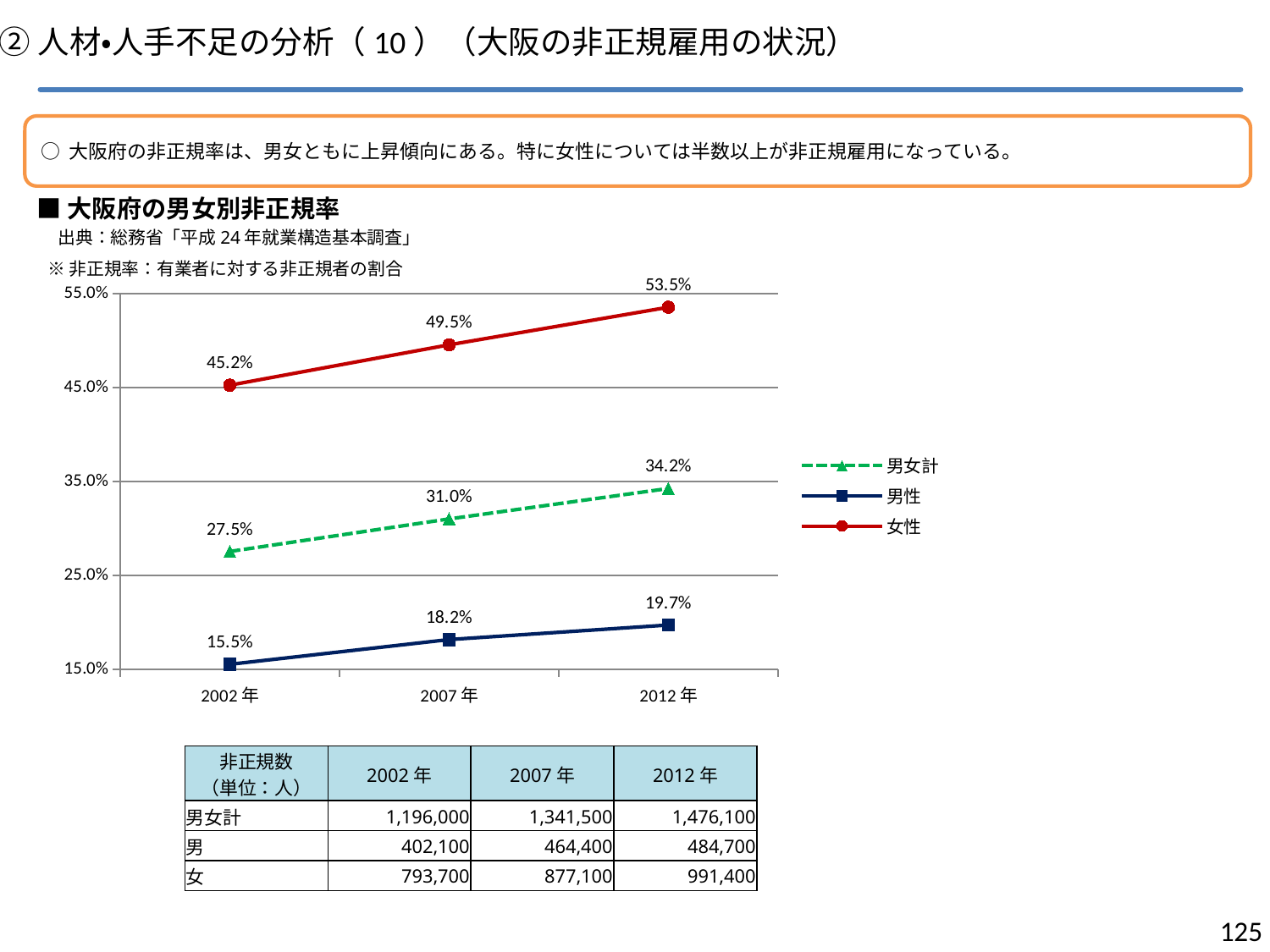
What is the value for 男女計 in 2007年? 31.0% What is the value for 男性 in 2002年? 15.5% What type of chart is shown on the slide? line chart Does the 男性 series rise or fall from 2002年 to 2012年? rise What is the difference between the 女性 value and the 男性 value in 2012年? 33.8% How many series does the legend list? 3 Which series has the highest value in 2012年? 女性 Which is larger, the 男女計 value in 2012年 or the 女性 value in 2002年? 女性 in 2002年 Which series has the lowest value in 2002年? 男性 How many years are shown on the x axis? 3 What is the value for 女性 in 2012年? 53.5% Which series is drawn with a dashed line? 男女計